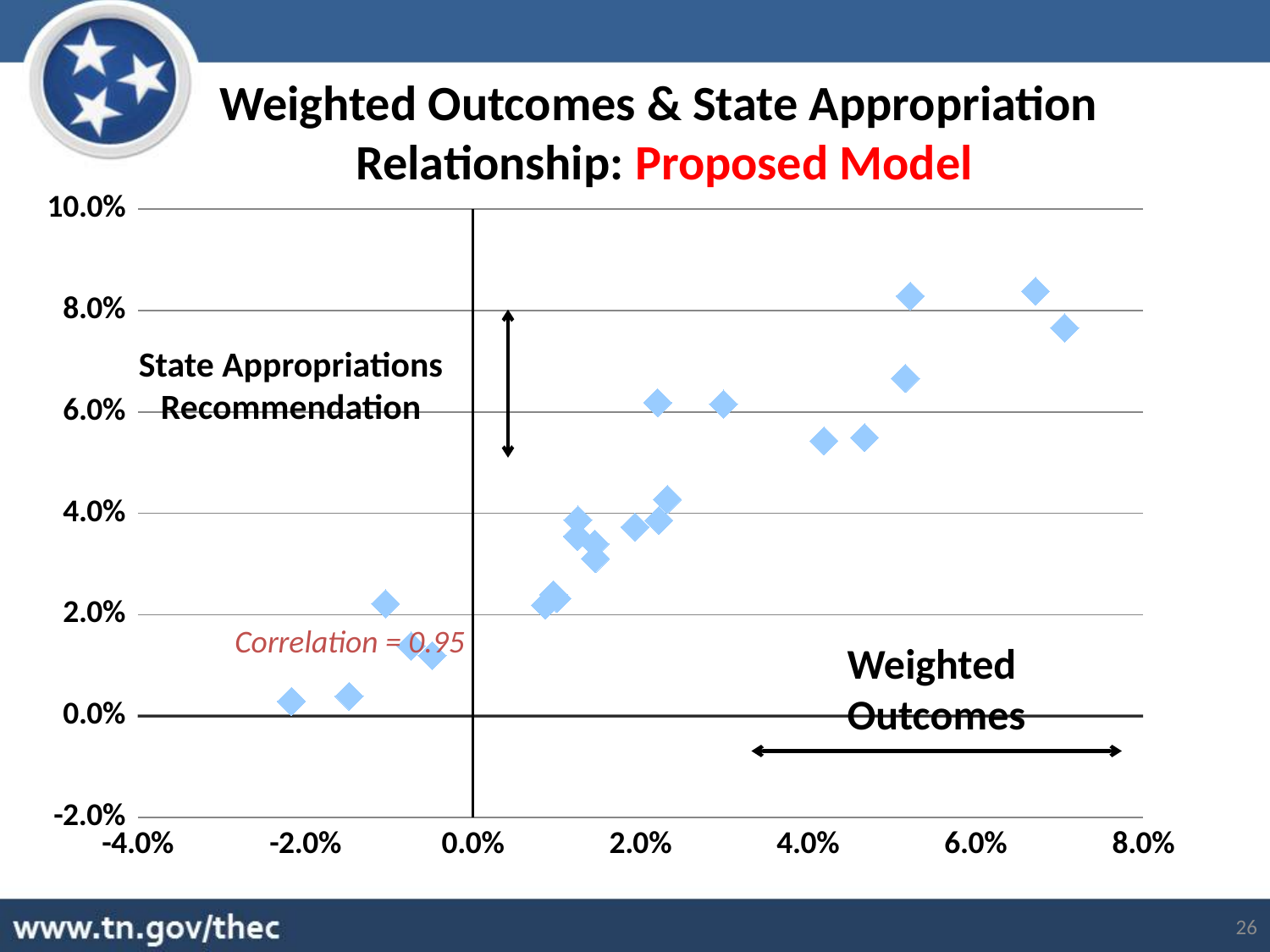
What is the highest value shown on the x axis? 8.0% What kind of chart is shown on the slide? Scatter chart Is the x-value of the rightmost plotted point greater or less than 6.0%? greater Is the y-value of the lowest plotted point greater or less than 2.0%? less What correlation value is printed on the chart? Correlation = 0.95 What is the lowest value shown on the x axis? -4.0% Is the y-value of the leftmost plotted point greater or less than 2.0%? less What is the title of the chart? Weighted Outcomes & State Appropriation Relationship: Proposed Model What is the highest value shown on the y axis? 10.0% As Weighted Outcomes increase along the x axis, do the State Appropriations Recommendation values generally rise or fall? Rise